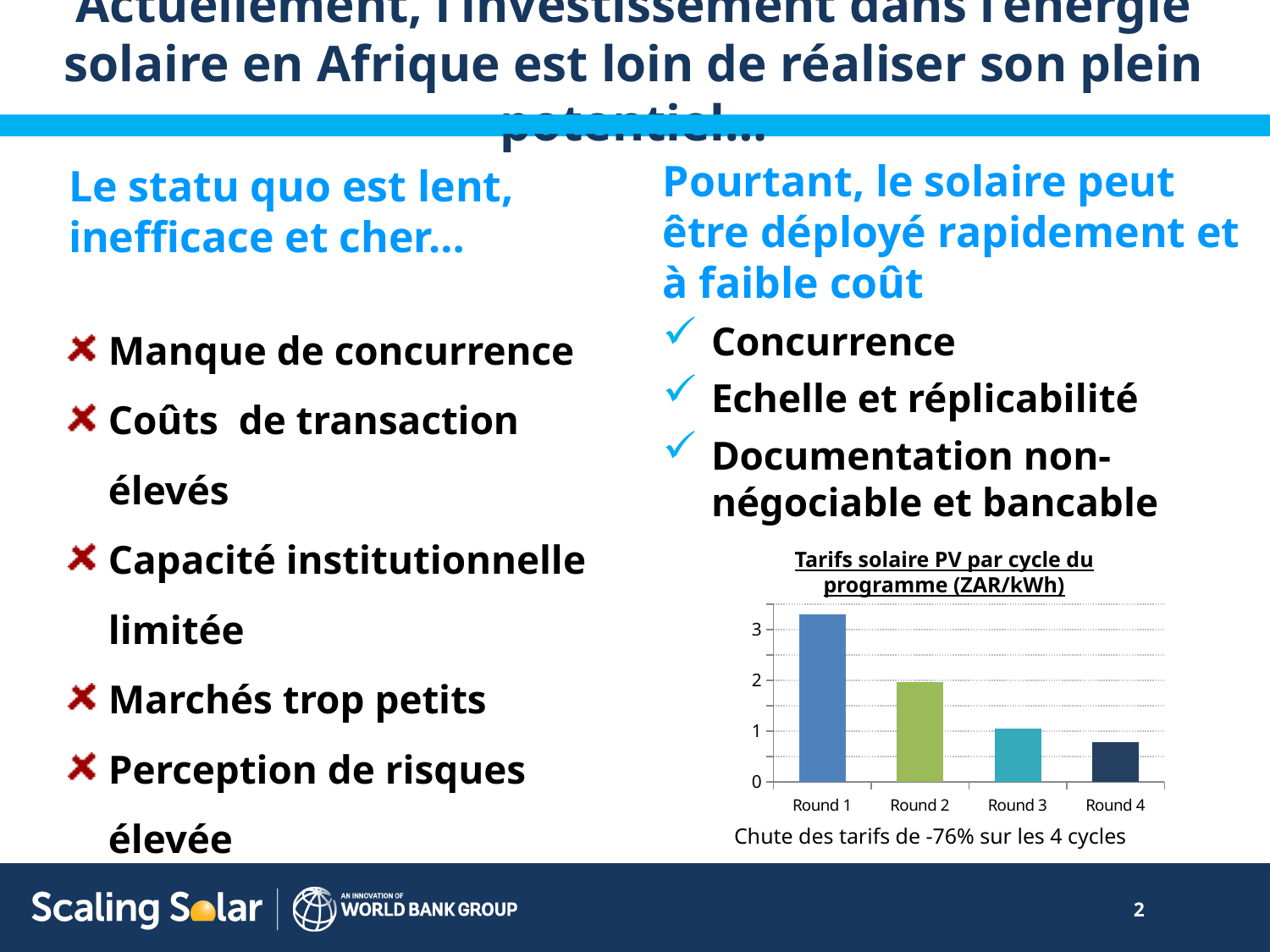
Which round has the highest tariff in the chart? Round 1 Is the value for Round 3 greater or less than 2? less Is the value for Round 4 greater or less than 1? less How many rounds (categories) are plotted in the chart? 4 Is the value for Round 2 greater or less than 1? greater According to the caption below the chart, by what percentage did tariffs fall over the 4 cycles? -76% What is the title of the chart on the slide? Tarifs solaire PV par cycle du programme (ZAR/kWh) What kind of chart is shown on the slide? bar chart Which is larger, the value for Round 1 or the value for Round 2? Round 1 Which round has the lowest tariff in the chart? Round 4 Do the tariff values rise or fall from Round 1 to Round 4? fall